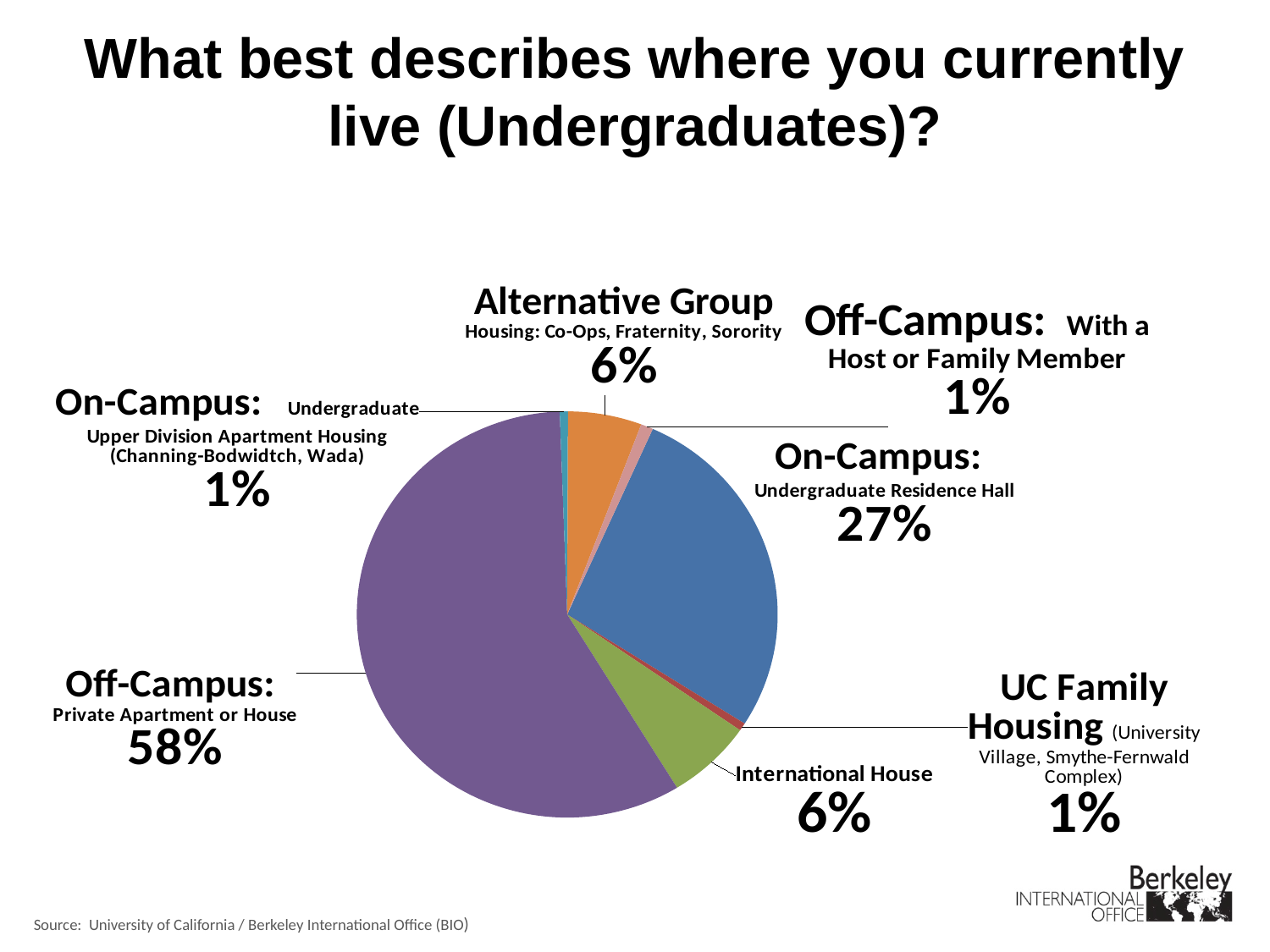
What share of undergraduates live off-campus with a host or family member? 1% What is the difference in percentage points between the off-campus private apartment or house share and the on-campus undergraduate residence hall share? 31 What share of undergraduates live in an on-campus undergraduate residence hall? 27% What is the title of the slide? What best describes where you currently live (Undergraduates)? What share of undergraduates live in alternative group housing (co-ops, fraternity, sorority)? 6% What share of undergraduates live in UC Family Housing? 1% How many slices does the pie chart have? 7 What share of undergraduates live in an off-campus private apartment or house? 58% Which is larger: the share living in an on-campus undergraduate residence hall or the share living in International House? On-Campus: Undergraduate Residence Hall Which living situation has the largest share of undergraduates? Off-Campus: Private Apartment or House What share of undergraduates live in International House? 6% What kind of chart is shown on the slide? pie chart